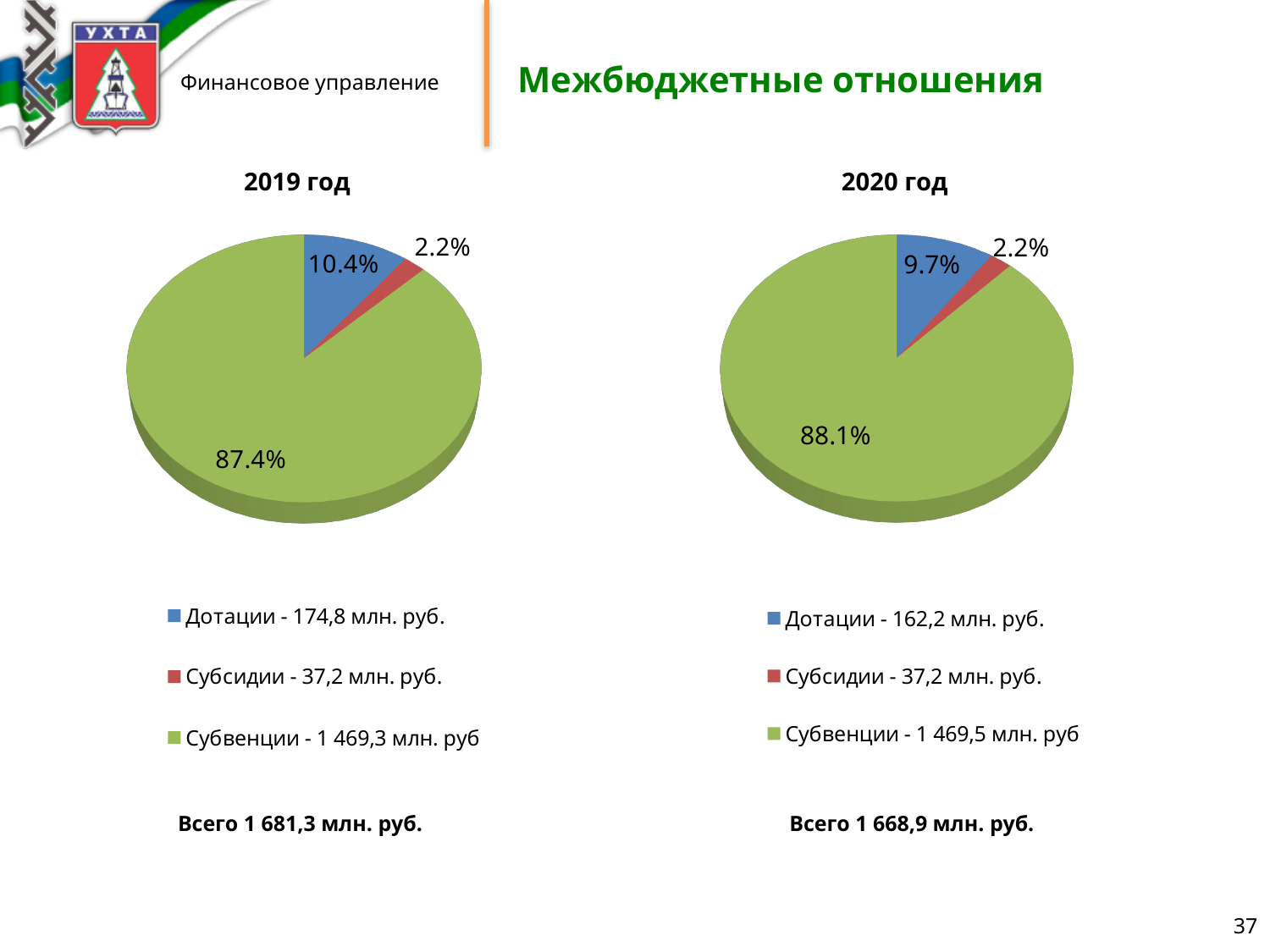
In the 2019 год chart, what is the difference in percentage points between the Дотации and Субсидии slices? 8.2 percentage points In the 2020 год chart, what value does the legend give for Субвенции? 1 469,5 млн. руб How many slices does the 2019 год pie chart have? 3 In the 2019 год chart, which category has the largest slice? Субвенции In the 2020 год chart, which slice is larger, Дотации or Субсидии? Дотации In the 2019 год chart, what share of the pie does Субвенции take? 87.4% In the 2019 год chart, what value does the legend give for Дотации? 174,8 млн. руб. In the 2019 год chart, what share of the pie does Субсидии take? 2.2% What type of chart is used for 2020 год? Pie chart In the 2020 год chart, which category has the smallest slice? Субсидии In the 2020 год chart, what share of the pie does Субвенции take? 88.1%